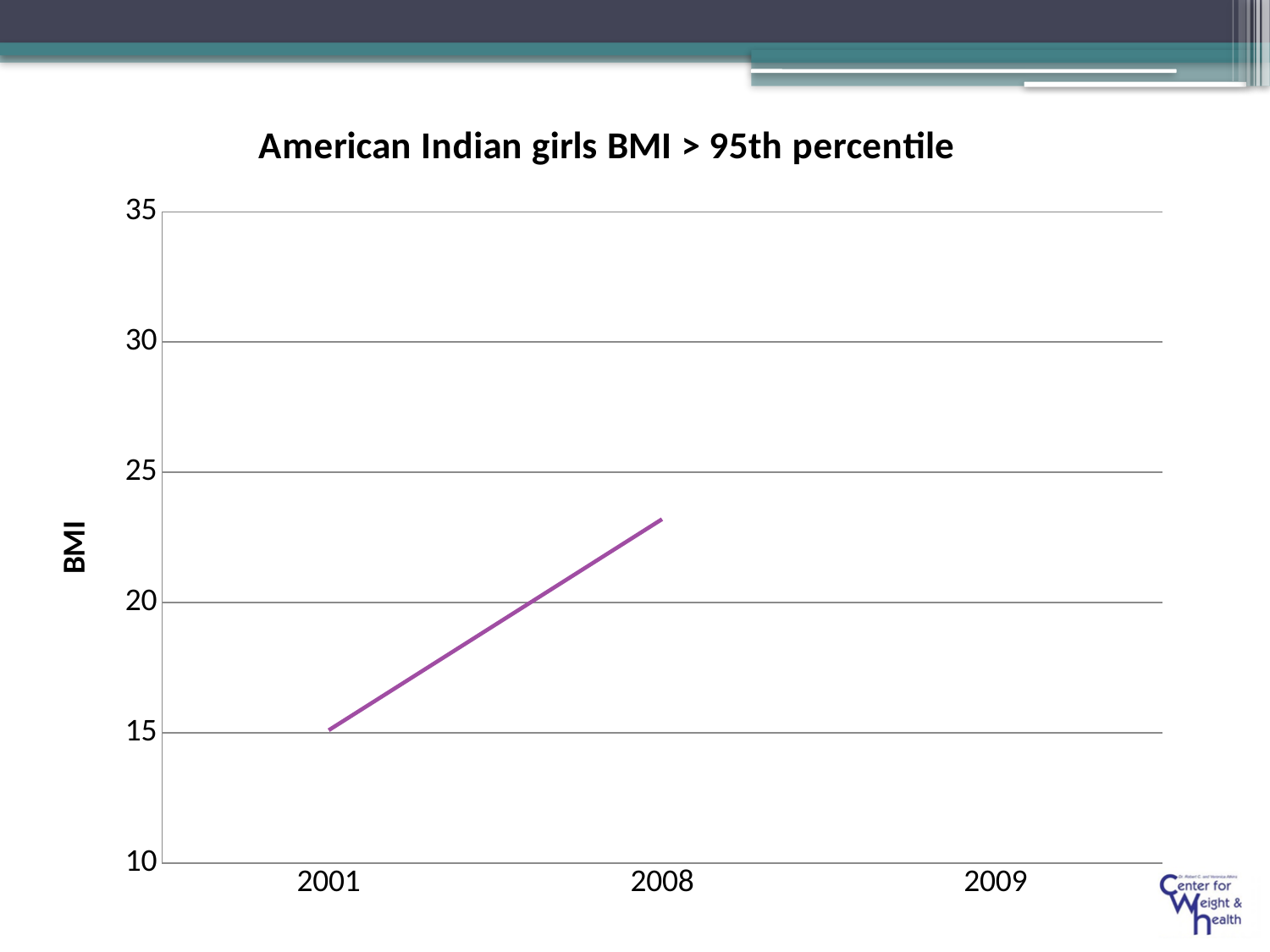
What is the title of the chart? American Indian girls BMI > 95th percentile Does the BMI line rise or fall from 2001 to 2008? rise What is the label on the vertical axis of the chart? BMI Which plotted year has the highest BMI value? 2008 Which plotted year has the lowest BMI value? 2001 Is the BMI value for 2008 greater or less than 20? greater Is the BMI value for 2001 greater or less than 20? less Which year has the larger BMI value, 2001 or 2008? 2008 What kind of chart is shown on the slide? line chart Is the BMI value for 2008 greater or less than 25? less How many year labels are shown on the x axis? 3